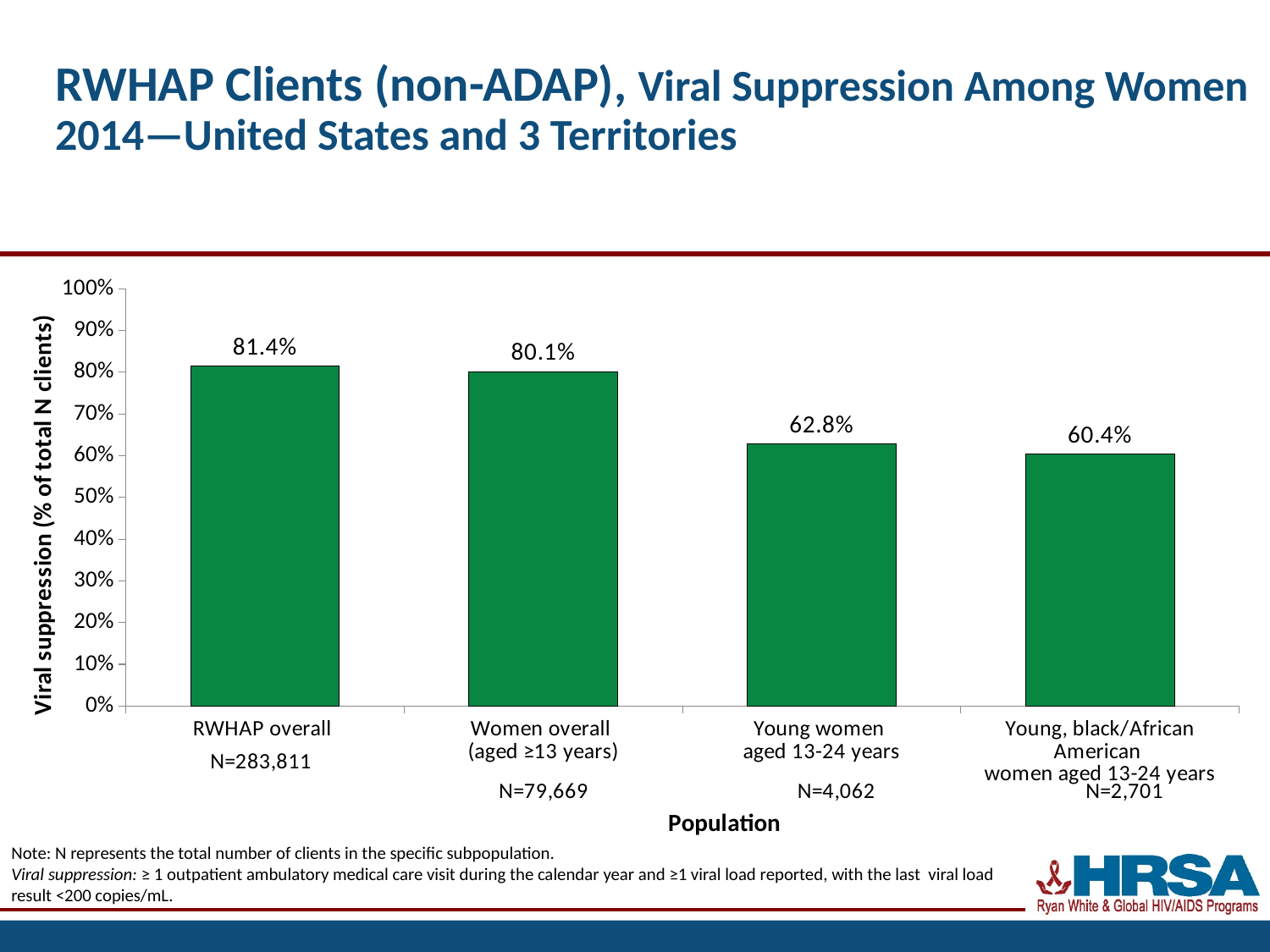
What is the N (number of clients) for the Young women aged 13-24 years population? N=4,062 What is the viral suppression percentage for Young women aged 13-24 years? 62.8% What is the difference in viral suppression between Women overall (aged ≥13 years) and Young, black/African American women aged 13-24 years? 19.7 percentage points Which population has the highest viral suppression percentage? RWHAP overall How many populations are shown in the chart? 4 Which population has the lowest viral suppression percentage? Young, black/African American women aged 13-24 years What kind of chart is shown on the slide? Bar chart What is the viral suppression percentage for Women overall (aged ≥13 years)? 80.1% What is the viral suppression percentage for Young, black/African American women aged 13-24 years? 60.4% What is the difference in viral suppression between RWHAP overall and Young women aged 13-24 years? 18.6 percentage points What is the viral suppression percentage for RWHAP overall? 81.4% Which has a higher viral suppression percentage: Women overall (aged ≥13 years) or Young women aged 13-24 years? Women overall (aged ≥13 years)